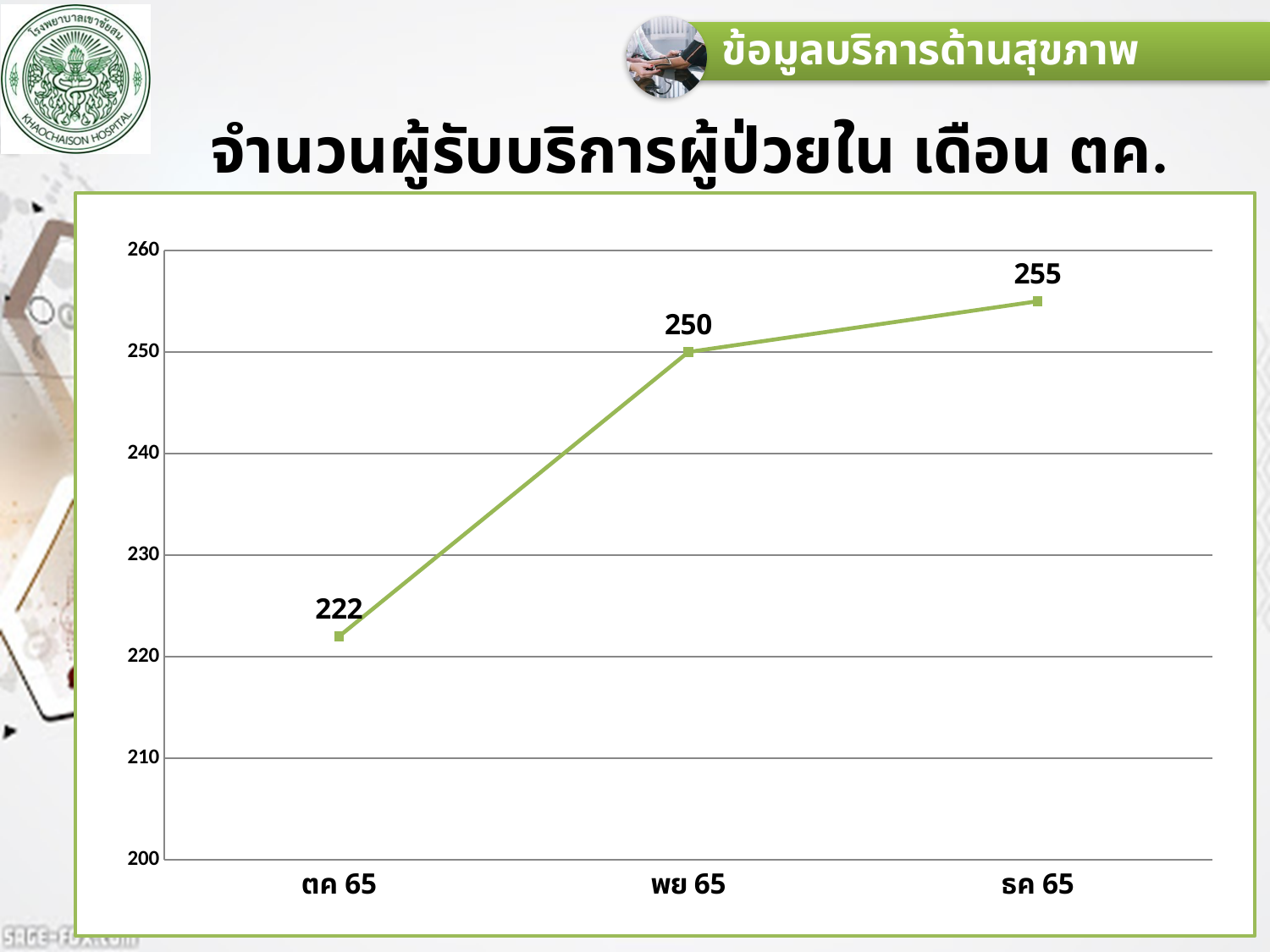
What is the difference between the values for ธค 65 and พย 65? 5 Which month has the lowest value? ตค 65 Which month has the highest value? ธค 65 What is the value for ตค 65? 222 What is the value for ธค 65? 255 What is the difference between the values for พย 65 and ตค 65? 28 Do the values rise or fall from ตค 65 to ธค 65? rise What is the value for พย 65? 250 Which is larger, the value for ตค 65 or the value for พย 65? พย 65 Is the value for ตค 65 greater or less than 230? less What kind of chart is shown on the slide? line chart How many data points are plotted on the chart? 3